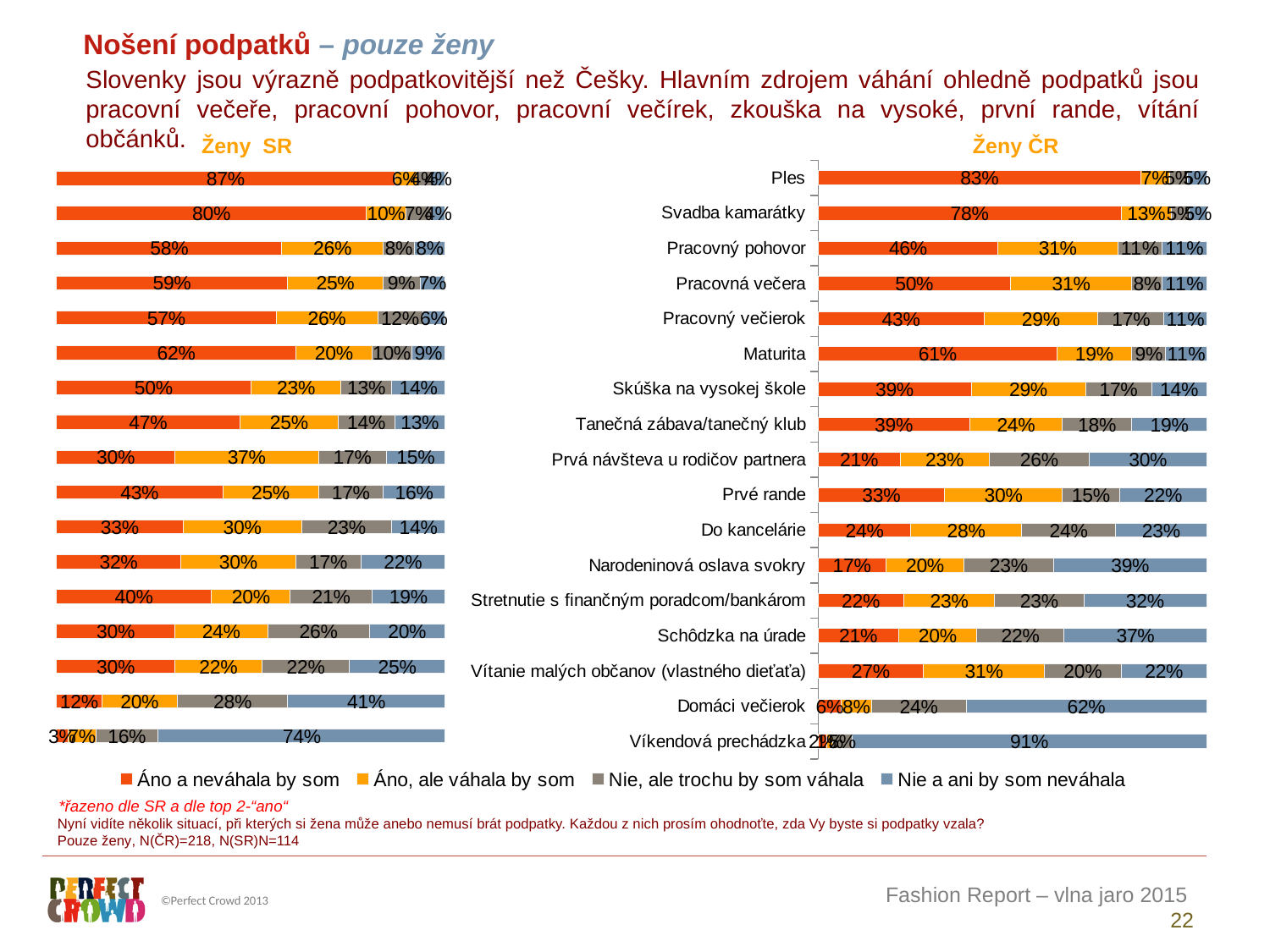
How many situations (categories) are shown in each chart? 17 What is the title of the chart on the right side of the slide? Ženy ČR How many series does the legend list? 4 In the Ženy SR chart, what is the "Áno, ale váhala by som" value for Prvá návšteva u rodičov partnera? 37% In the Ženy ČR chart, which category has the highest "Nie a ani by som neváhala" value? Víkendová prechádzka In the Ženy SR chart, what is the "Áno a neváhala by som" value for Svadba kamarátky? 80% In the Ženy SR chart, which category has the lowest "Áno a neváhala by som" value? Víkendová prechádzka What type of chart is used on this slide? Stacked bar chart In the Ženy ČR chart, what percentage of women answered "Áno a neváhala by som" for Ples? 83% For Maturita, is the "Áno a neváhala by som" value larger in the Ženy SR chart or the Ženy ČR chart? Ženy SR In the Ženy ČR chart, what is the "Nie a ani by som neváhala" value for Domáci večierok? 62%